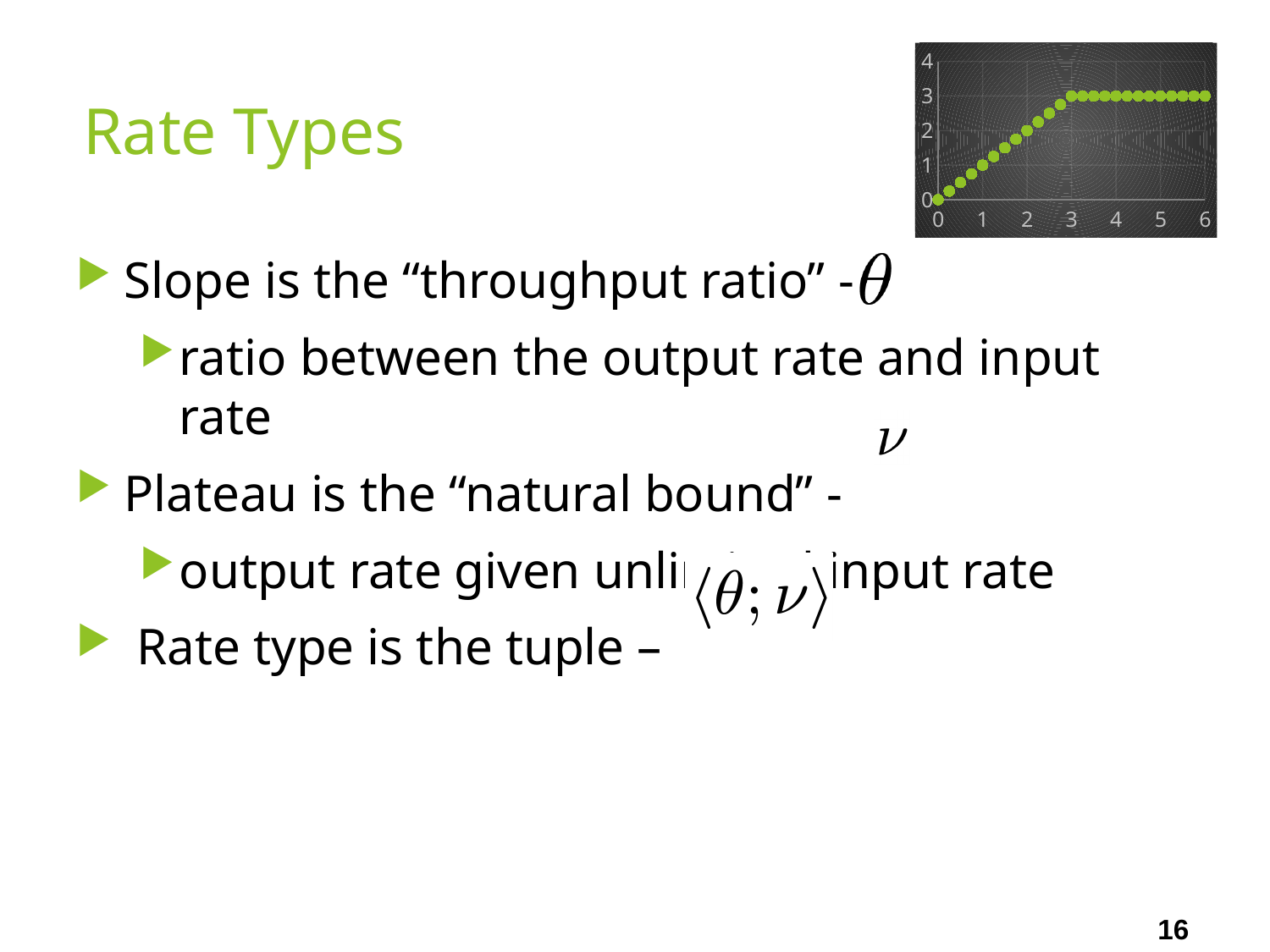
Is the plotted value at x = 2 greater or less than 3? less At what y-axis value does the plateau of the plotted points lie? 3 What is the highest tick value shown on the x axis of the chart? 6 What is the highest tick value shown on the y axis of the chart? 4 Is the plotted value at x = 5 greater or less than 2? greater How many data series are plotted in the chart? 1 Is the plotted value at x = 4 greater or less than 4? less What kind of chart is shown in the top right of the slide? scatter chart In the chart, do the plotted values rise, fall, or stay flat as x increases from 0 to 3? rise In the chart, do the plotted values rise, fall, or stay flat as x increases from 3 to 6? stay flat